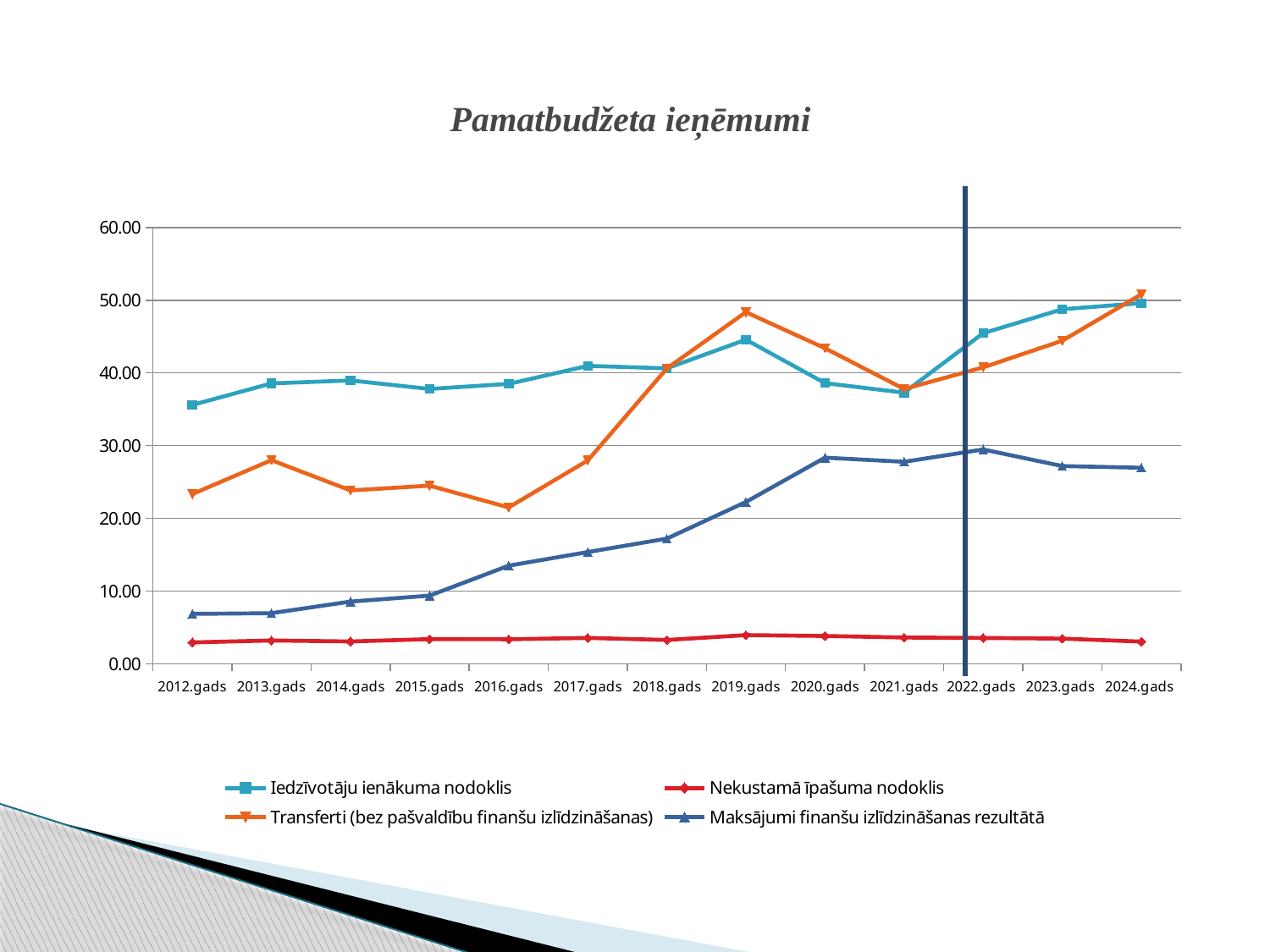
How many years are shown on the x axis? 13 Which series has the lowest values across all years? Nekustamā īpašuma nodoklis In 2019.gads, which is larger: Transferti (bez pašvaldību finanšu izlīdzināšanas) or Iedzīvotāju ienākuma nodoklis? Transferti (bez pašvaldību finanšu izlīdzināšanas) What is the title of the chart? Pamatbudžeta ieņēmumi Is the value for Nekustamā īpašuma nodoklis in 2024.gads greater or less than 10.00? less Is the value for Transferti (bez pašvaldību finanšu izlīdzināšanas) in 2019.gads greater or less than 40.00? greater Is the value for Iedzīvotāju ienākuma nodoklis in 2012.gads greater or less than 40.00? less How many series does the legend list? 4 What kind of chart is shown on the slide? line chart In which year does Transferti (bez pašvaldību finanšu izlīdzināšanas) reach its highest value? 2024.gads Does Maksājumi finanšu izlīdzināšanas rezultātā rise or fall from 2012.gads to 2020.gads? rise